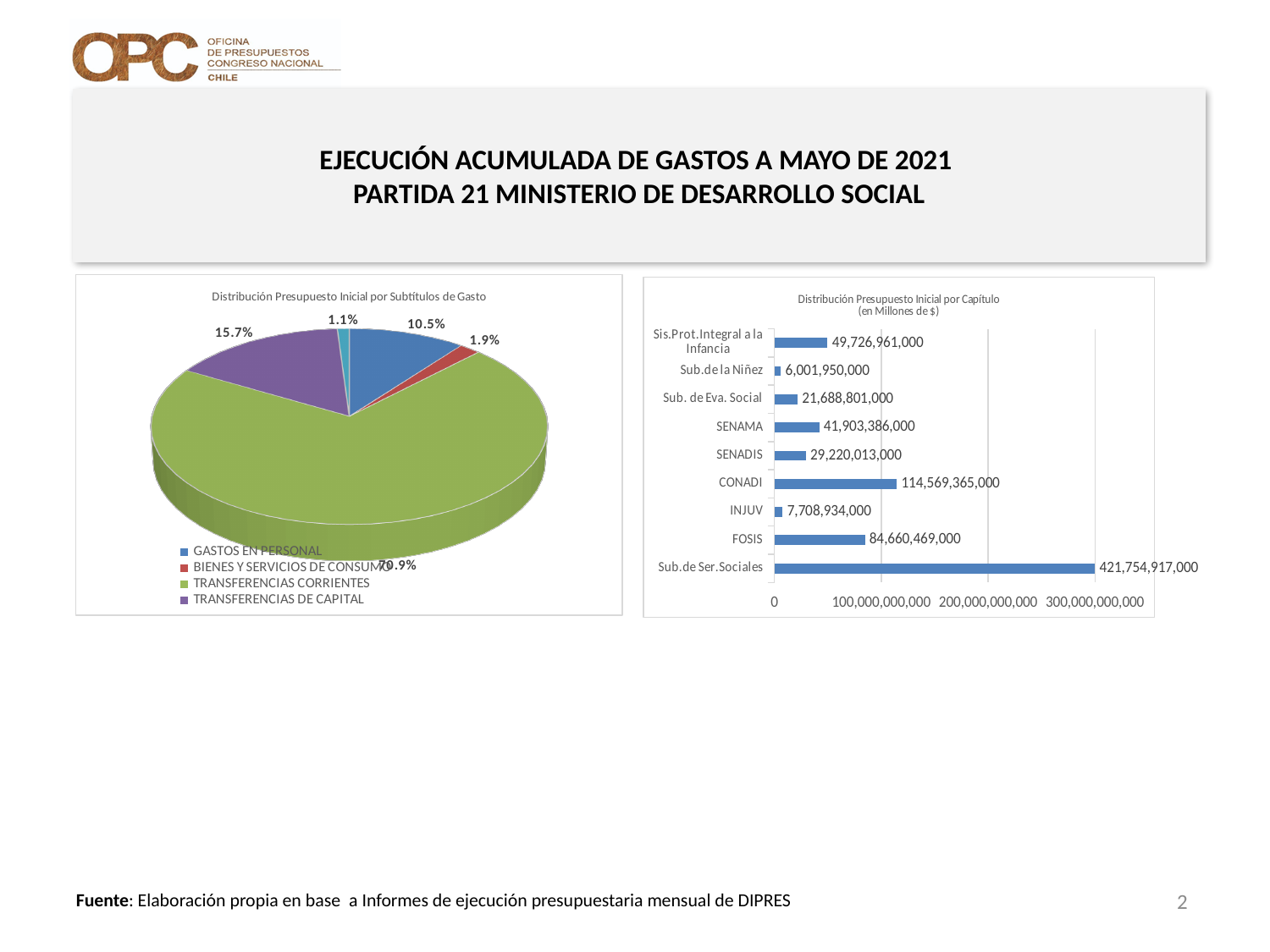
In the chart titled 'Distribución Presupuesto Inicial por Capítulo', which is larger, the value for SENADIS or the value for Sub. de Eva. Social? SENADIS In the chart titled 'Distribución Presupuesto Inicial por Capítulo', what is the value for FOSIS? 84,660,469,000 In the chart titled 'Distribución Presupuesto Inicial por Capítulo', what is the difference between the values for CONADI and FOSIS? 29,908,896,000 In the chart titled 'Distribución Presupuesto Inicial por Capítulo', which category has the lowest value? Sub.de la Niñez In the chart titled 'Distribución Presupuesto Inicial por Capítulo', how many categories are shown? 9 In the chart titled 'Distribución Presupuesto Inicial por Capítulo', what is the value for CONADI? 114,569,365,000 In the pie chart titled 'Distribución Presupuesto Inicial por Subtítulos de Gasto', what share does TRANSFERENCIAS CORRIENTES have? 70.9% What kind of chart is the chart titled 'Distribución Presupuesto Inicial por Capítulo'? Bar chart In the pie chart titled 'Distribución Presupuesto Inicial por Subtítulos de Gasto', how many entries does the legend list? 4 In the pie chart titled 'Distribución Presupuesto Inicial por Subtítulos de Gasto', what share does TRANSFERENCIAS DE CAPITAL have? 15.7% In the chart titled 'Distribución Presupuesto Inicial por Capítulo', what is the value for SENAMA? 41,903,386,000 In the chart titled 'Distribución Presupuesto Inicial por Capítulo', which category has the highest value? Sub.de Ser.Sociales